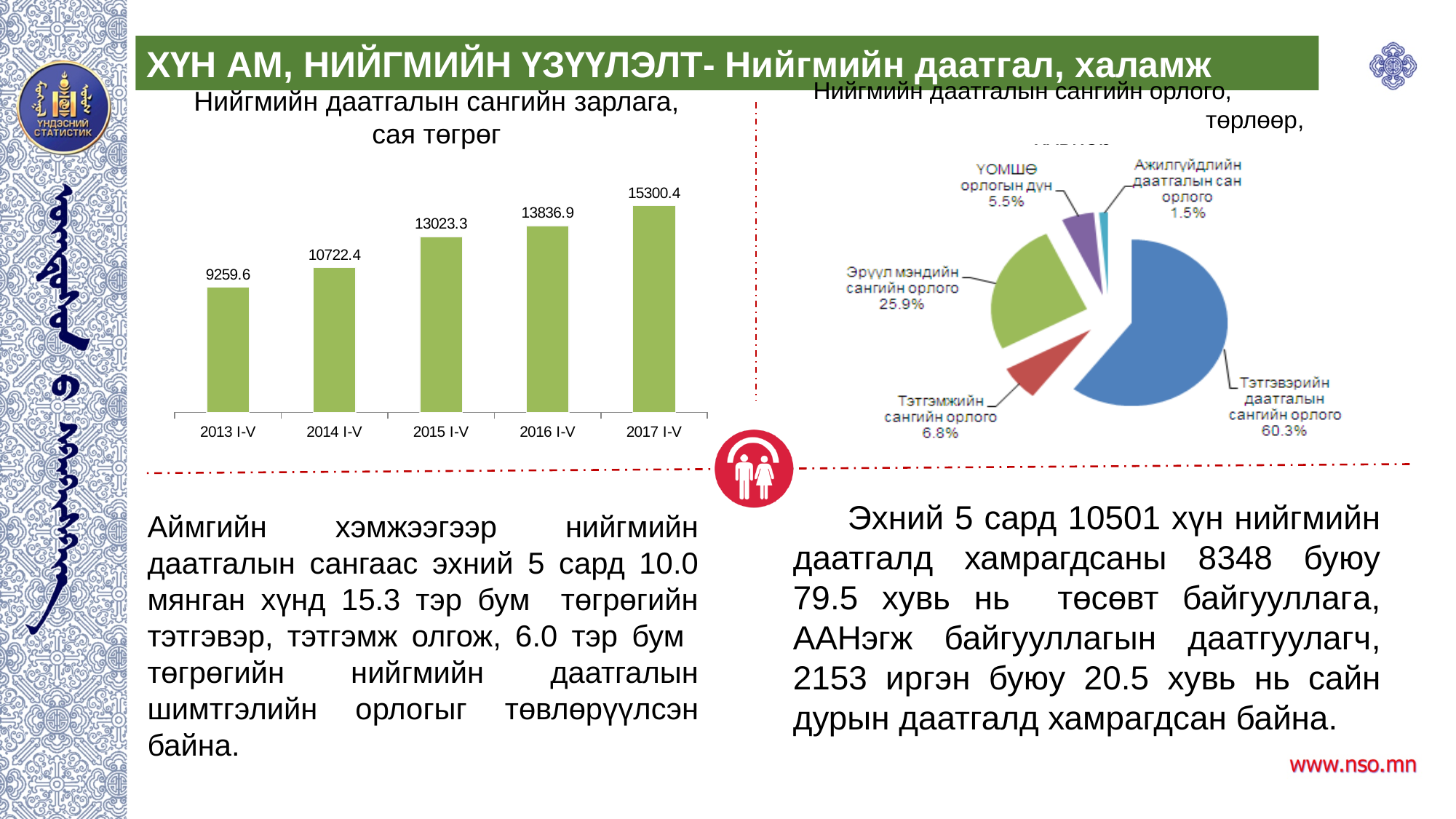
In the bar chart on the left, what is the difference between the values for 2017 I-V and 2016 I-V? 1463.5 In the bar chart on the left, do the values rise or fall from 2013 I-V to 2017 I-V? rise In the pie chart on the right, which category has the smallest share? Ажилгүйдлийн даатгалын сан орлого In the pie chart on the right, what share does Эрүүл мэндийн сангийн орлого have? 25.9% In the bar chart on the left, what is the value for 2017 I-V? 15300.4 In the pie chart on the right, what share does Тэтгэврийн даатгалын сангийн орлого have? 60.3% What kind of chart is the chart on the left of the slide? bar chart In the bar chart on the left, which period has the lowest value? 2013 I-V In the bar chart on the left, which period has the highest value? 2017 I-V In the bar chart on the left, what is the value for 2013 I-V? 9259.6 In the bar chart on the left, how many periods are shown? 5 In the pie chart on the right, how many slices are there? 5